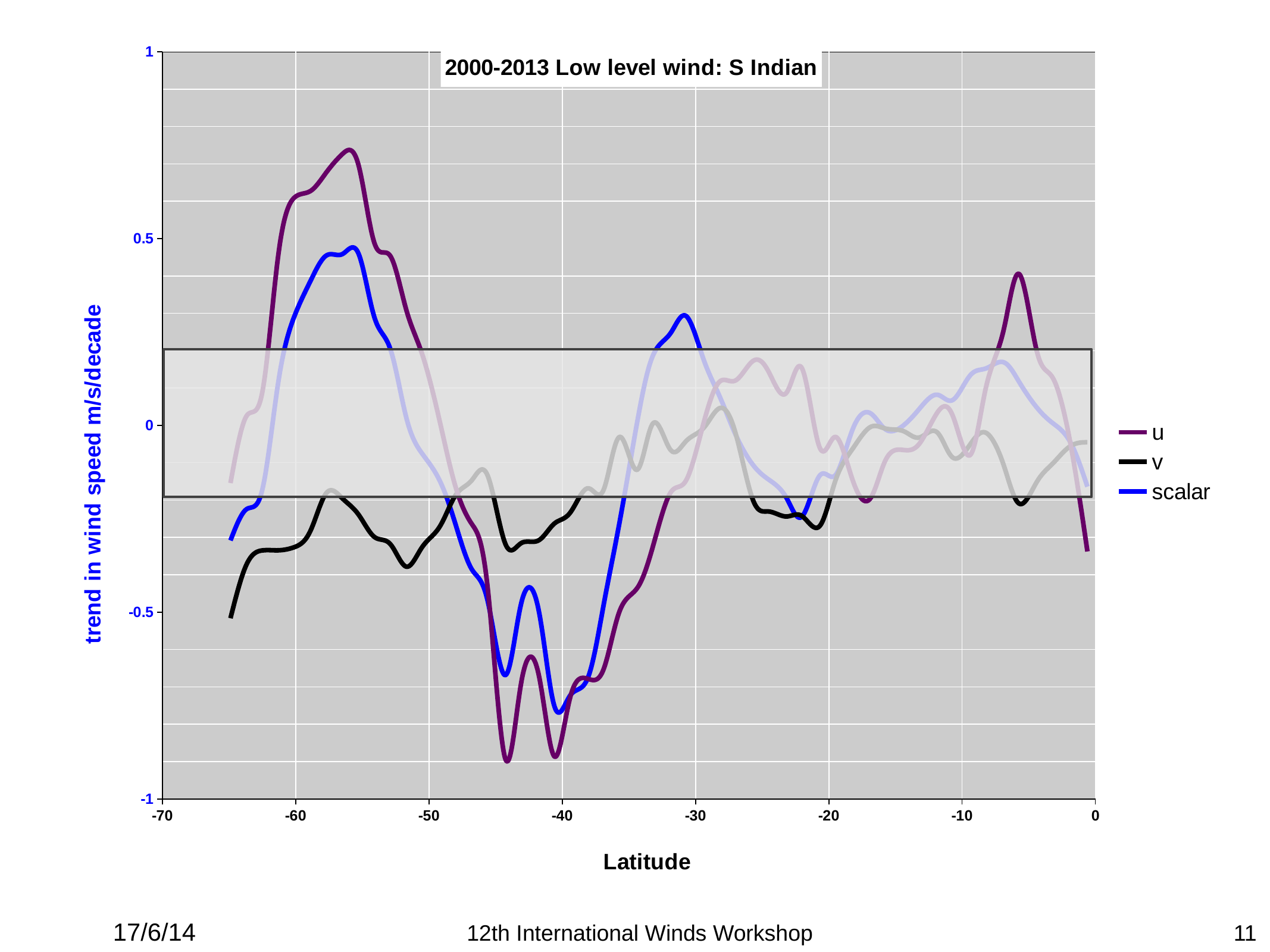
Does the u series rise or fall as latitude goes from -50 to -44? fall How many series does the legend list? 3 Is the value of the v series at latitude -52 greater or less than 0? less What kind of chart is shown on the slide? line chart What is the label of the x axis? Latitude What is the title of the chart? 2000-2013 Low level wind: S Indian At latitude -56, which series has the larger value, u or scalar? u Is the value of the v series at latitude -40 greater or less than -0.5? greater Is the value of the u series at latitude -56 greater or less than 0.5? greater Which series reaches the highest value anywhere on the chart? u